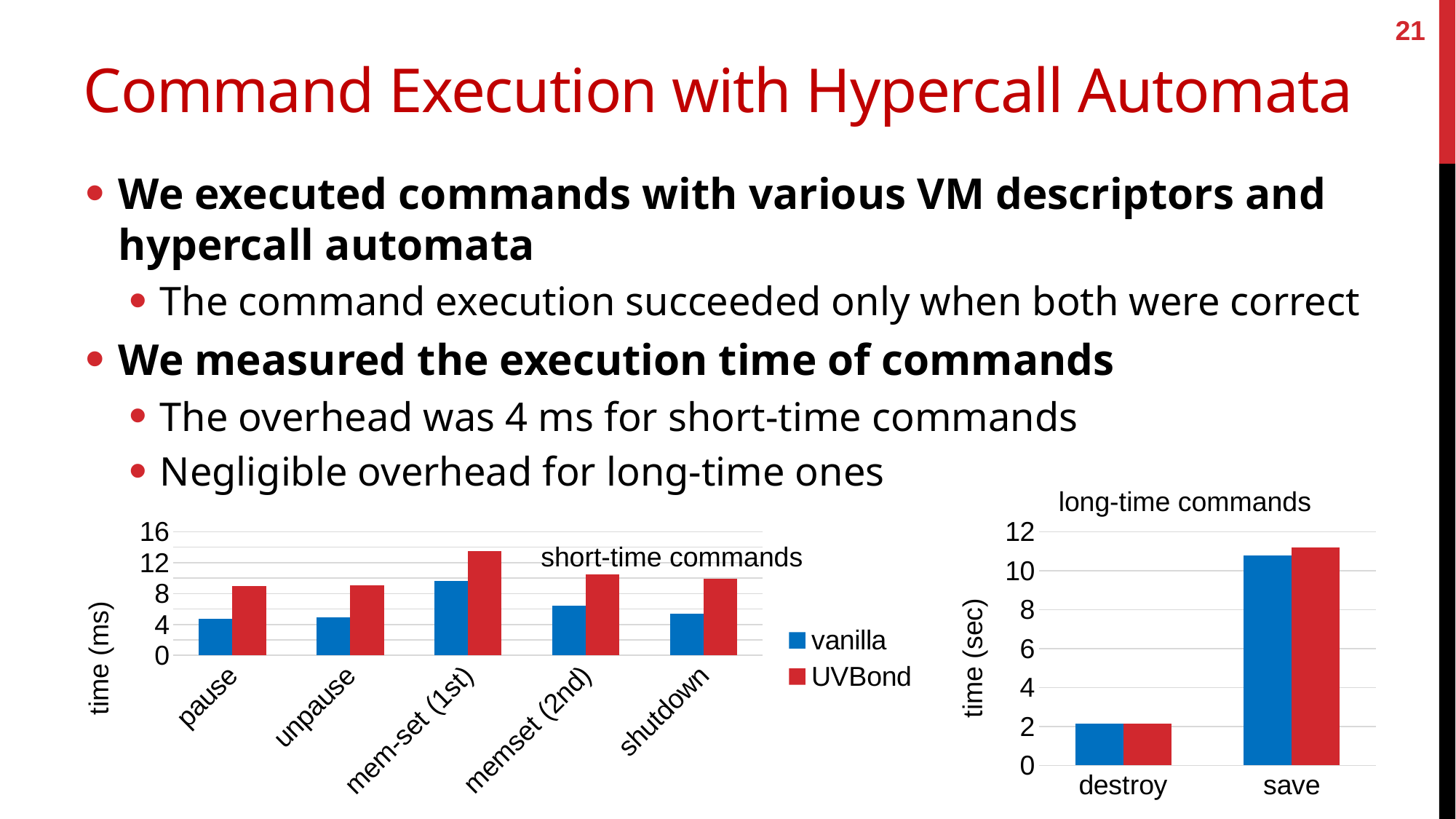
How many series does the legend of the short-time commands chart list? 2 In the short-time commands chart, is the vanilla value for pause greater or less than 8? less How many commands are shown on the x axis of the short-time commands chart? 5 How many commands are shown on the x axis of the long-time commands chart? 2 In the short-time commands chart, which command has the highest UVBond time? mem-set (1st) In the long-time commands chart, which command has the higher vanilla time? save In the short-time commands chart, is the UVBond value for mem-set (1st) greater or less than 12? greater In the short-time commands chart, which command has the highest vanilla time? mem-set (1st) What kind of chart is the short-time commands chart? bar chart In the short-time commands chart, which is larger for shutdown, vanilla or UVBond? UVBond What unit is used on the y axis of the long-time commands chart? time (sec) In the long-time commands chart, is the UVBond value for save greater or less than 10? greater